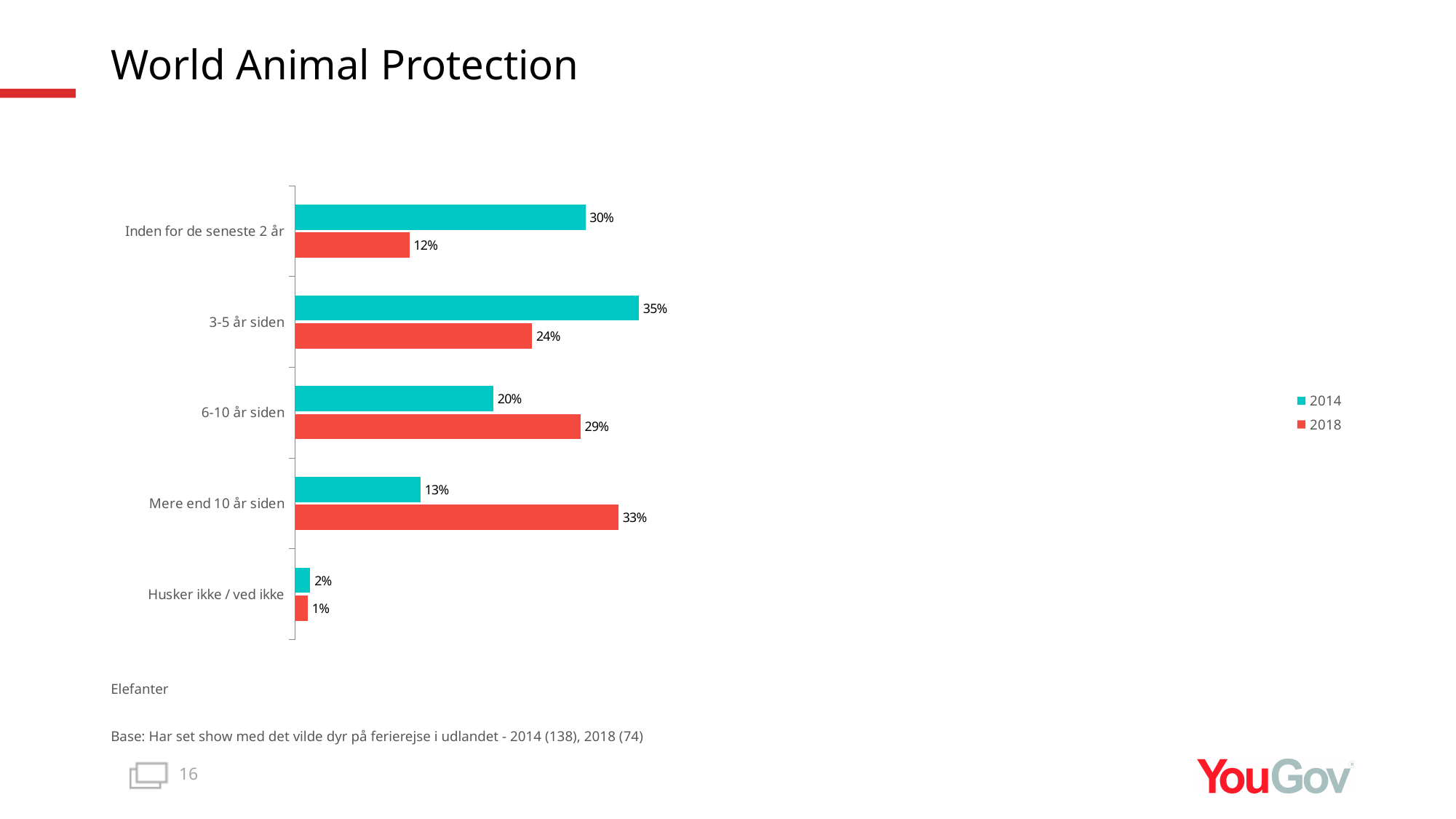
For "6-10 år siden", which series has the larger value, 2014 or 2018? 2018 Which category has the lowest 2018 value? Husker ikke / ved ikke How many series does the legend list? 2 What is the 2018 value for "Inden for de seneste 2 år"? 12% What is the difference between the 2014 and 2018 values for "Inden for de seneste 2 år"? 18 percentage points What type of chart is shown on the slide? Bar chart What is the difference between the 2018 and 2014 values for "Mere end 10 år siden"? 20 percentage points What is the 2018 value for "Mere end 10 år siden"? 33% How many categories are shown on the chart? 5 Which colour represents the 2018 series in the legend? Red What is the 2014 value for "3-5 år siden"? 35% Which category has the highest 2014 value? 3-5 år siden